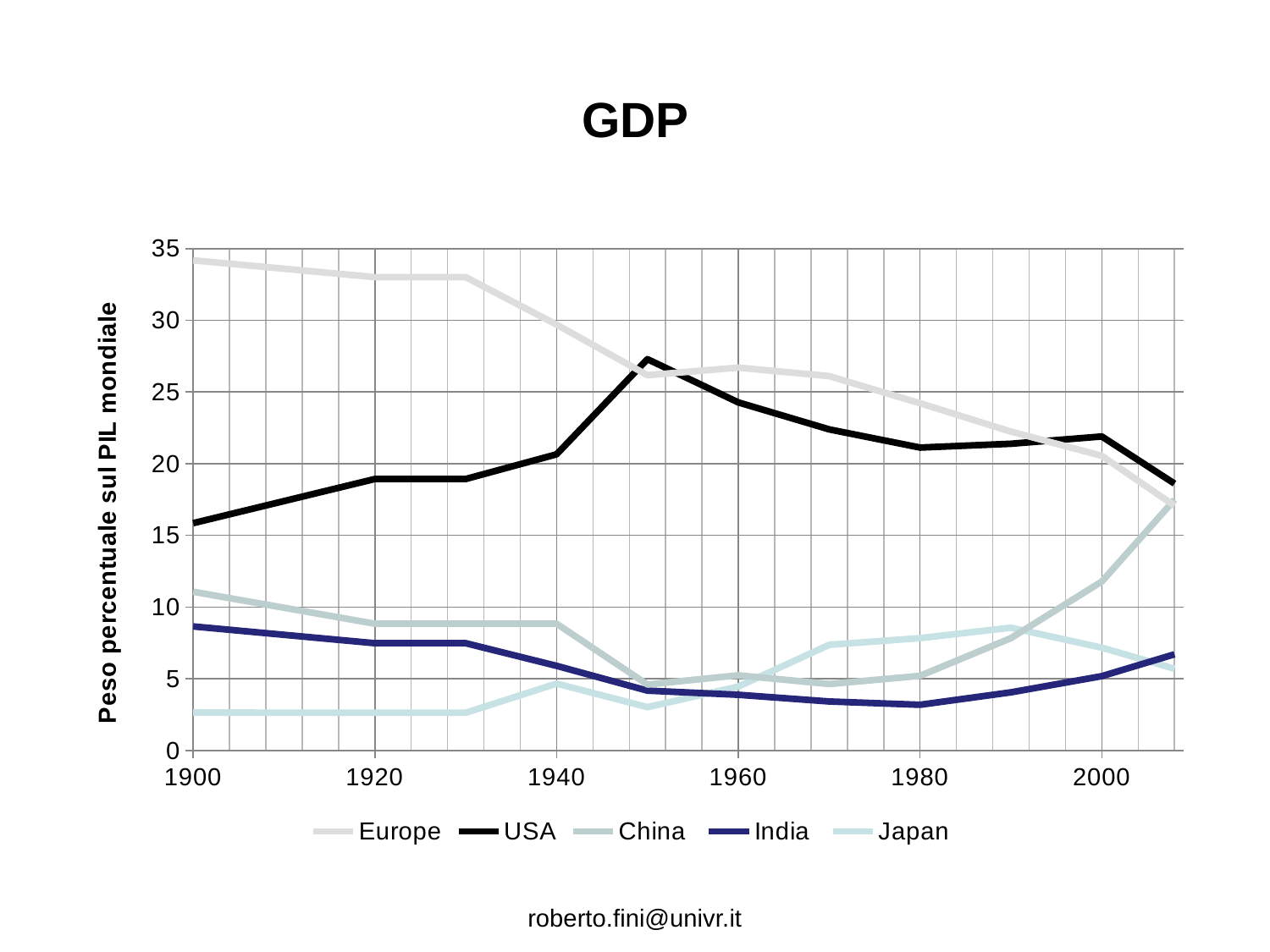
How many series does the legend list? 5 Is the value for Japan in 1900 greater or less than 5? less What is the title of the chart? GDP Which series has the lowest value in 1980? India Which series has the highest value in 1900? Europe Which series has the highest value in 1980? Europe What is the label on the vertical axis? Peso percentuale sul PIL mondiale Is the value for Europe in 1900 greater or less than 30? greater Which series has the lowest value in 1900? Japan In 1990, which is larger: the value for Japan or the value for India? Japan Does the Europe series rise or fall from 1900 to the end of the x axis? fall What kind of chart is shown on the slide? line chart